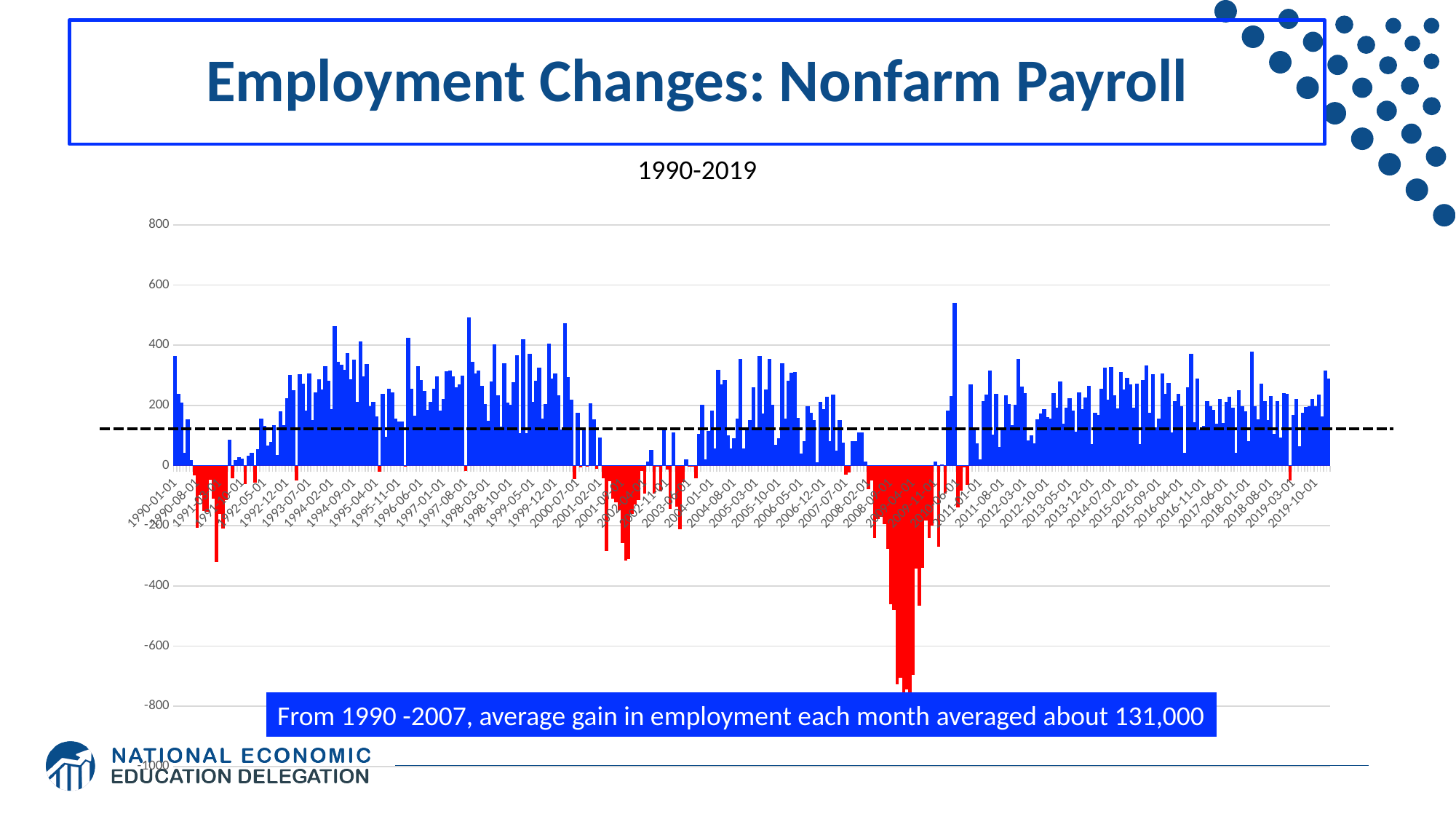
What is the title of the chart on the slide? Employment Changes: Nonfarm Payroll In which year does the chart show its lowest (most negative) monthly employment change? 2009 Is the tallest bar on the chart, around 2010, greater or less than 400? greater What kind of chart is shown on the slide? Bar chart Which colour is used for months with negative employment changes? Red According to the text box on the slide, what was the average monthly employment gain from 1990 to 2007? About 131,000 What period does the chart's subtitle say the data covers? 1990-2019 Is the most negative bar in 2009 greater or less than -600? less Are the bars in early 2009 greater or less than -200? less